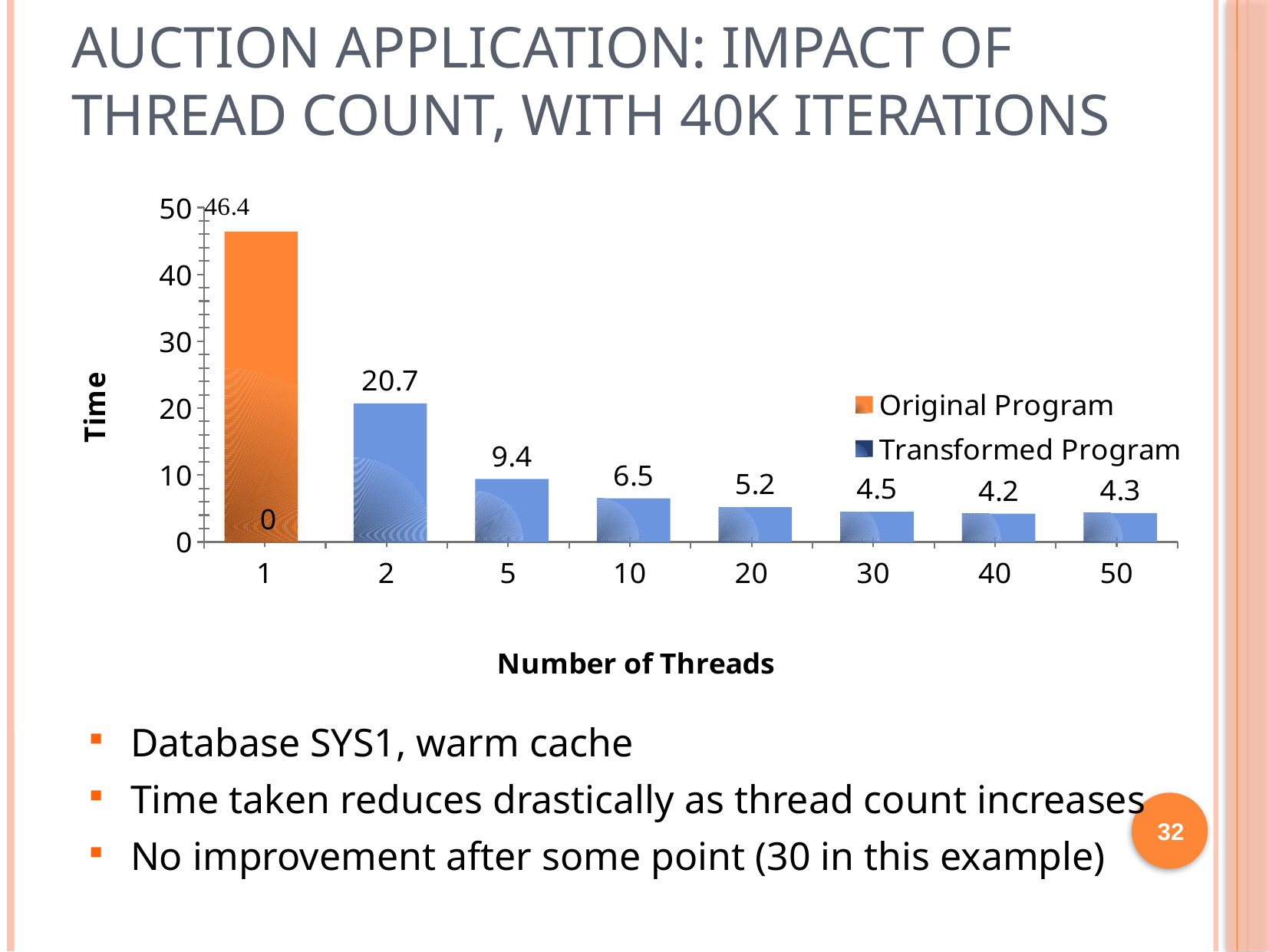
Which is larger: the Transformed Program value at 20 threads or at 30 threads? 20 threads How many thread-count categories are shown on the x axis? 8 What is the value for the Transformed Program at 2 threads? 20.7 What is the label of the x axis? Number of Threads What is the value for the Original Program at 1 thread? 46.4 How many series does the legend list? 2 What kind of chart is shown on the slide? Bar chart What is the difference between the Transformed Program values at 2 threads and 5 threads? 11.3 What is the value for the Transformed Program at 40 threads? 4.2 What is the value for the Transformed Program at 10 threads? 6.5 Do the Transformed Program values generally rise or fall as the number of threads increases from 2 to 40? Fall At which number of threads is the Transformed Program value lowest? 40